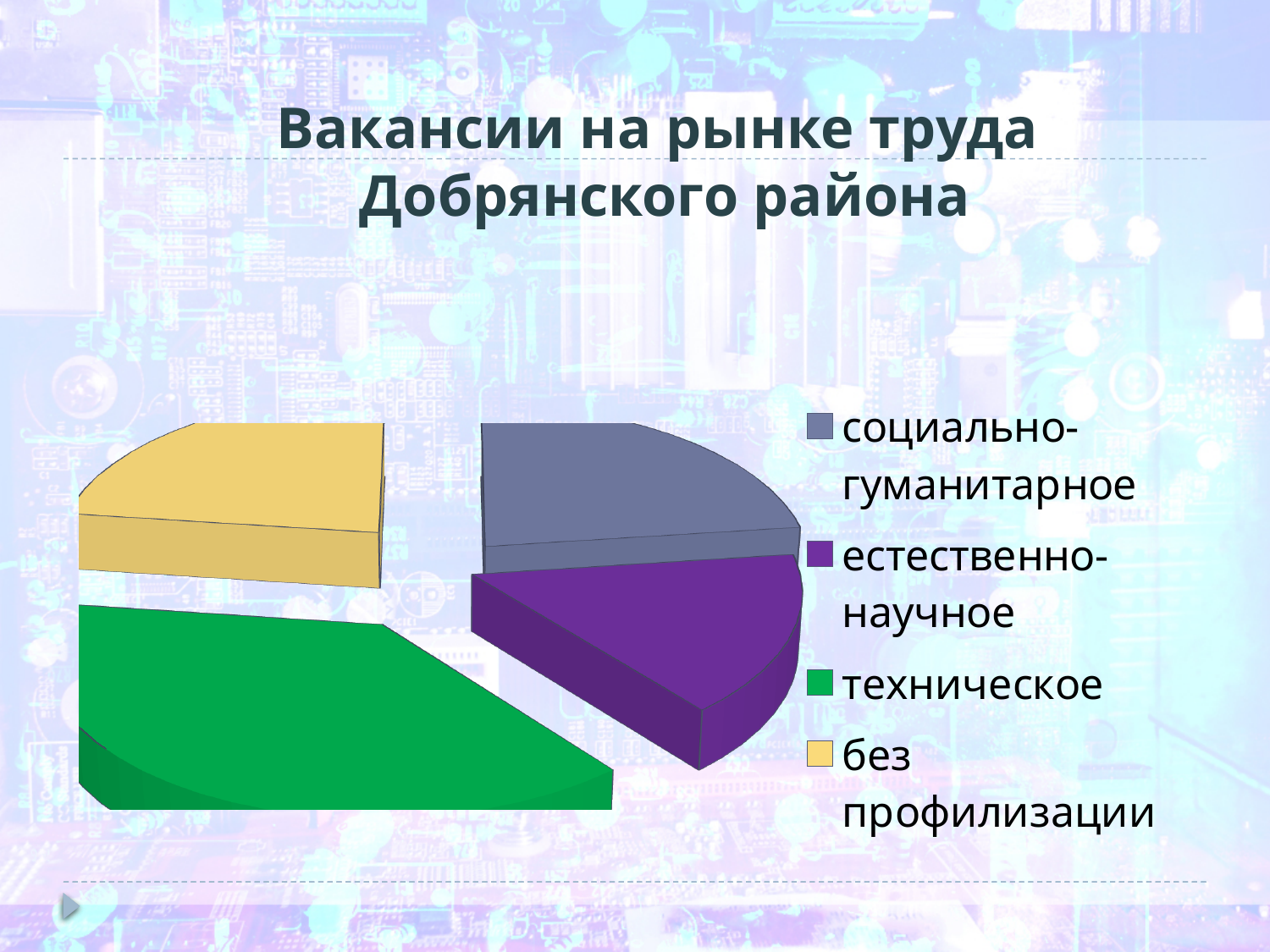
How many entries does the legend list? 4 Which slice is larger: техническое or естественно-научное? техническое What colour is the slice for техническое? green Which slice is larger: техническое or социально-гуманитарное? техническое What kind of chart is shown on the slide? pie chart What is the title of the chart on the slide? Вакансии на рынке труда Добрянского района Which category has the largest slice of the pie? техническое How many slices does the pie chart have? 4